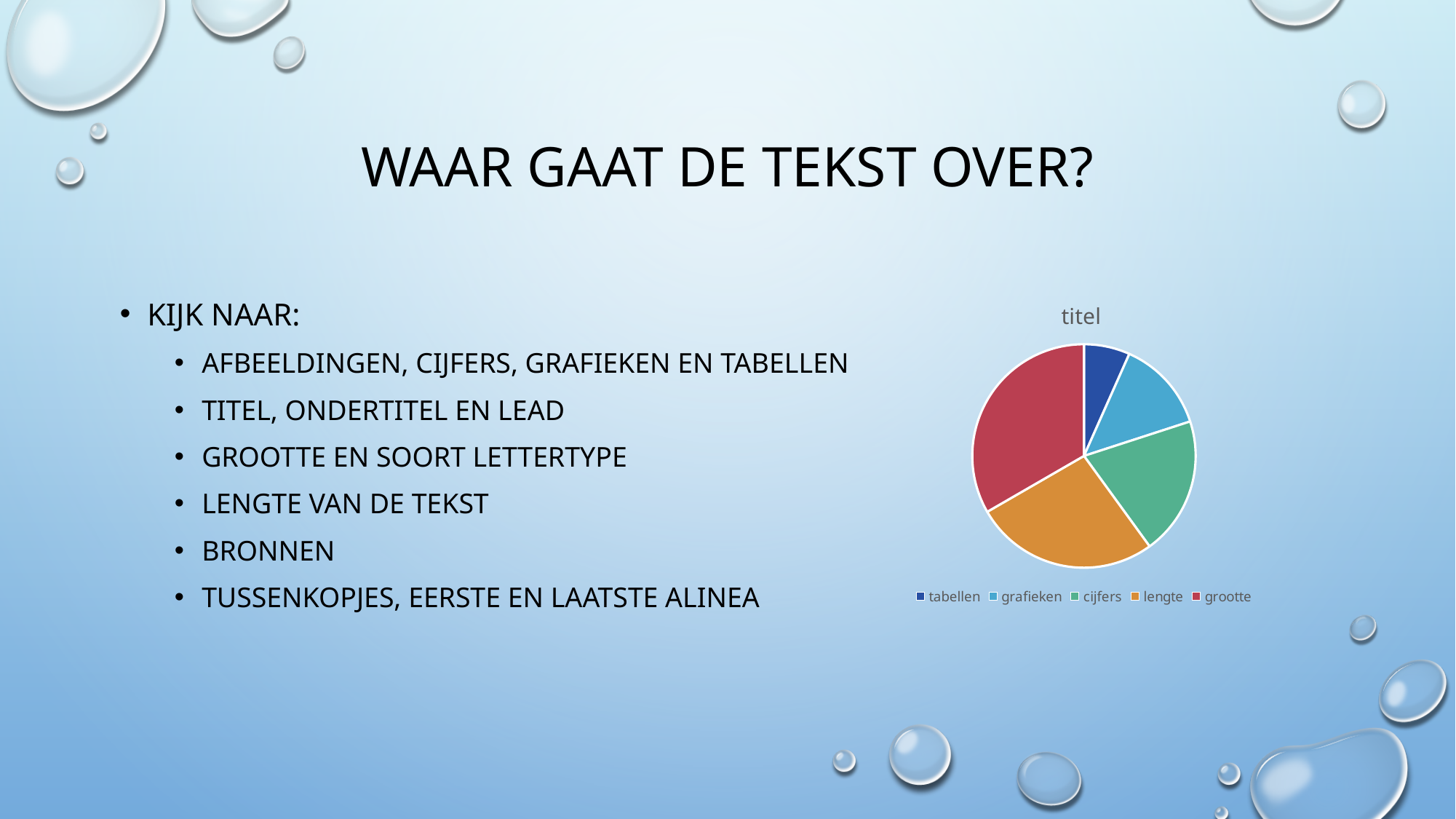
Which slice is larger, grootte or tabellen? grootte What is the title of the chart? titel Which category has the smallest slice of the pie chart? tabellen Which slice is larger, grootte or lengte? grootte How many entries does the chart legend list? 5 What kind of chart is shown on the slide? pie chart How many slices does the pie chart have? 5 Which slice is larger, cijfers or tabellen? cijfers What colour is the grootte slice in the pie chart? red Which category has the largest slice of the pie chart? grootte